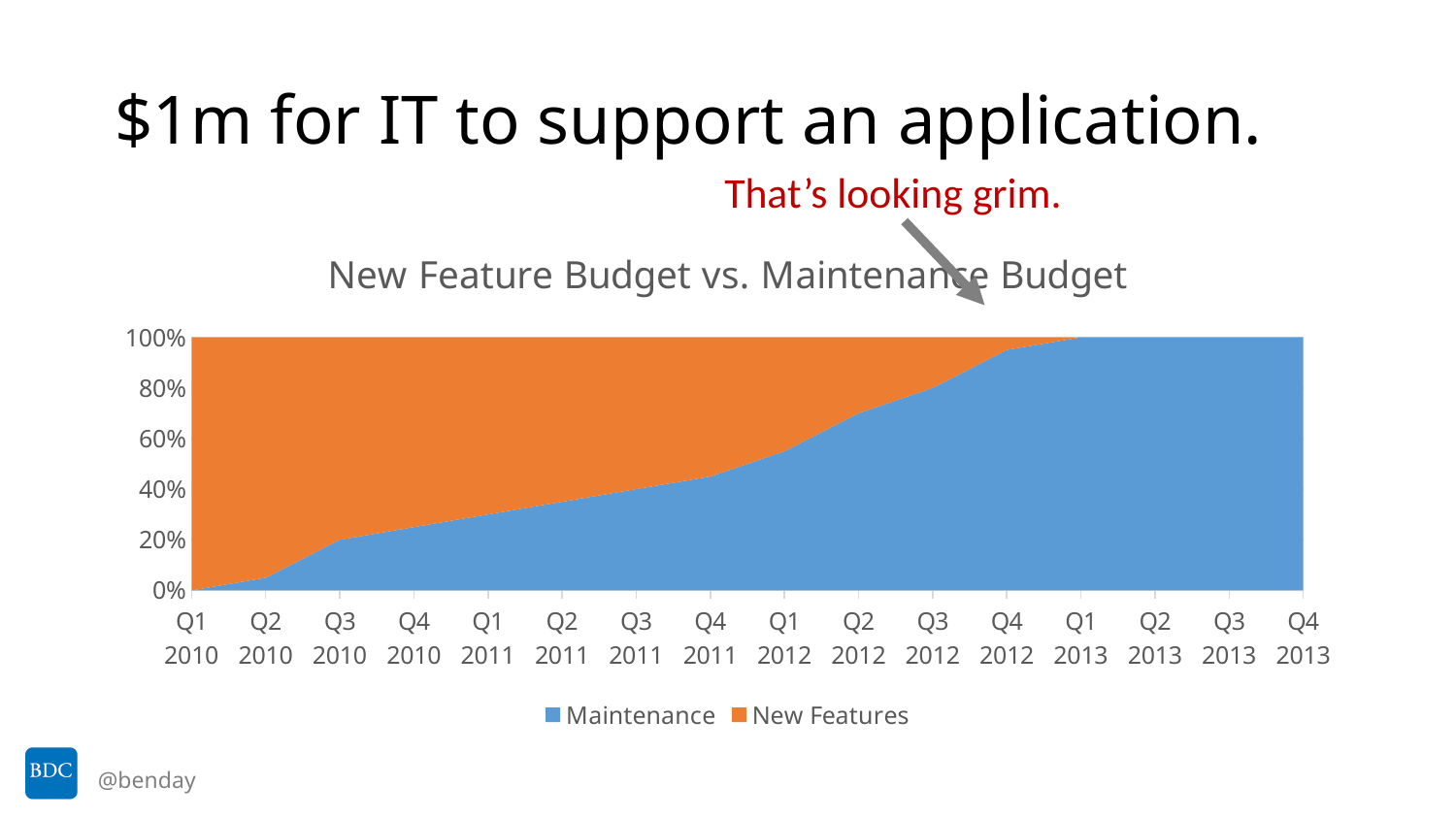
Does the Maintenance share rise or fall from Q1 2010 to Q4 2013? Rise Which series is shown in orange? New Features Is the Maintenance share in Q4 2011 greater or less than 60%? less In Q1 2010, which series has the larger share, Maintenance or New Features? New Features How many quarters are shown on the x axis? 16 Does the New Features share rise or fall from Q1 2010 to Q4 2013? Fall How many series does the legend list? 2 Is the Maintenance share in Q4 2012 greater or less than 80%? greater What kind of chart is shown on the slide? Area chart Is the Maintenance share in Q1 2010 greater or less than 20%? less Which quarter has the lowest Maintenance share? Q1 2010 What is the title of the chart? New Feature Budget vs. Maintenance Budget